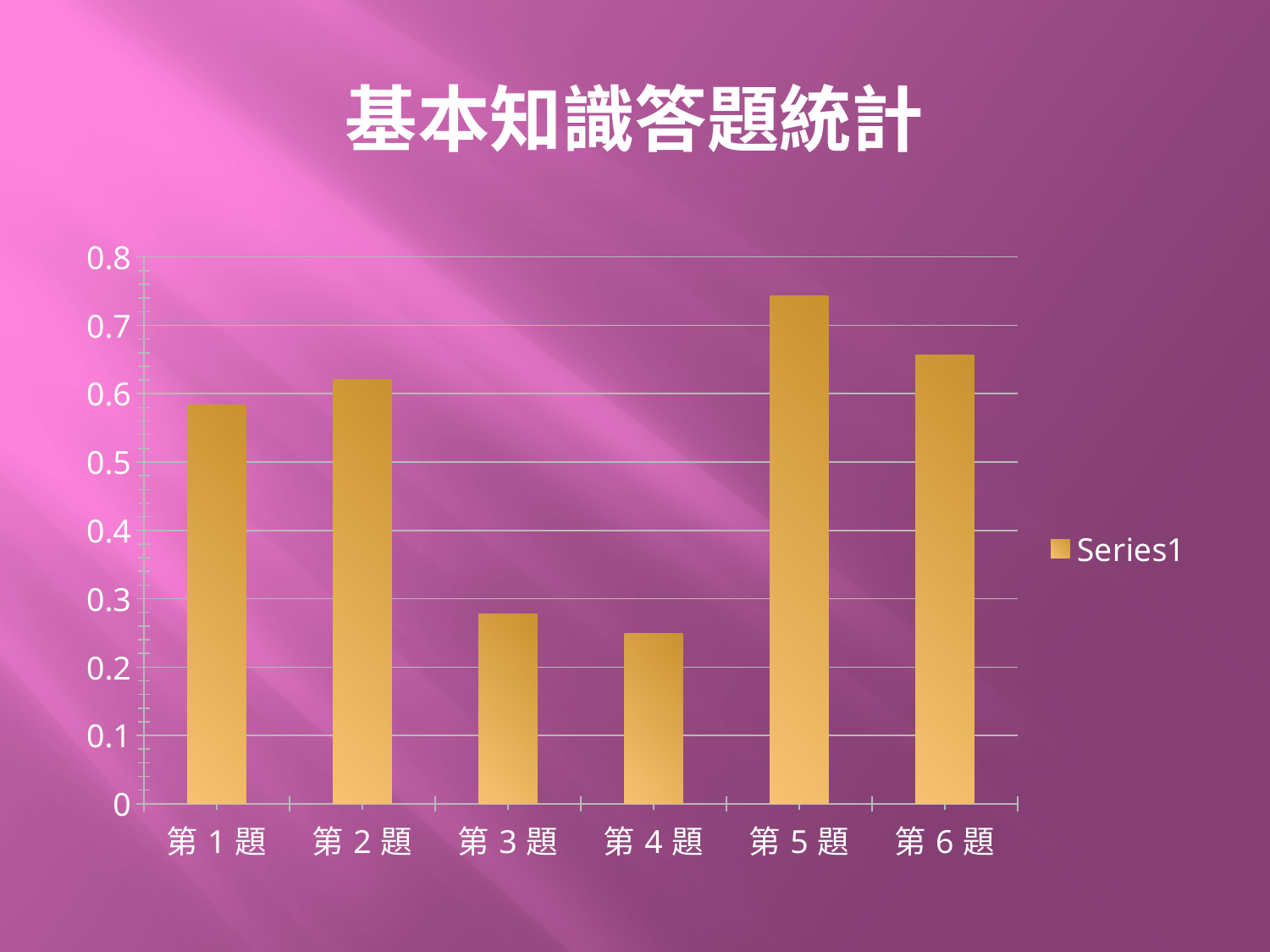
Is the value for 第 1 題 greater or less than 0.5? greater Is the value for 第 5 題 greater or less than 0.7? greater What is the title of the chart? 基本知識答題統計 How many categories are shown on the x axis of the chart? 6 What type of chart is shown on the slide? bar chart Which category has the highest bar? 第 5 題 Is the value for 第 6 題 greater or less than 0.6? greater Which is larger, the value for 第 1 題 or the value for 第 3 題? 第 1 題 What is the name of the series shown in the legend? Series1 Which category has the lowest bar? 第 4 題 How many series does the legend list? 1